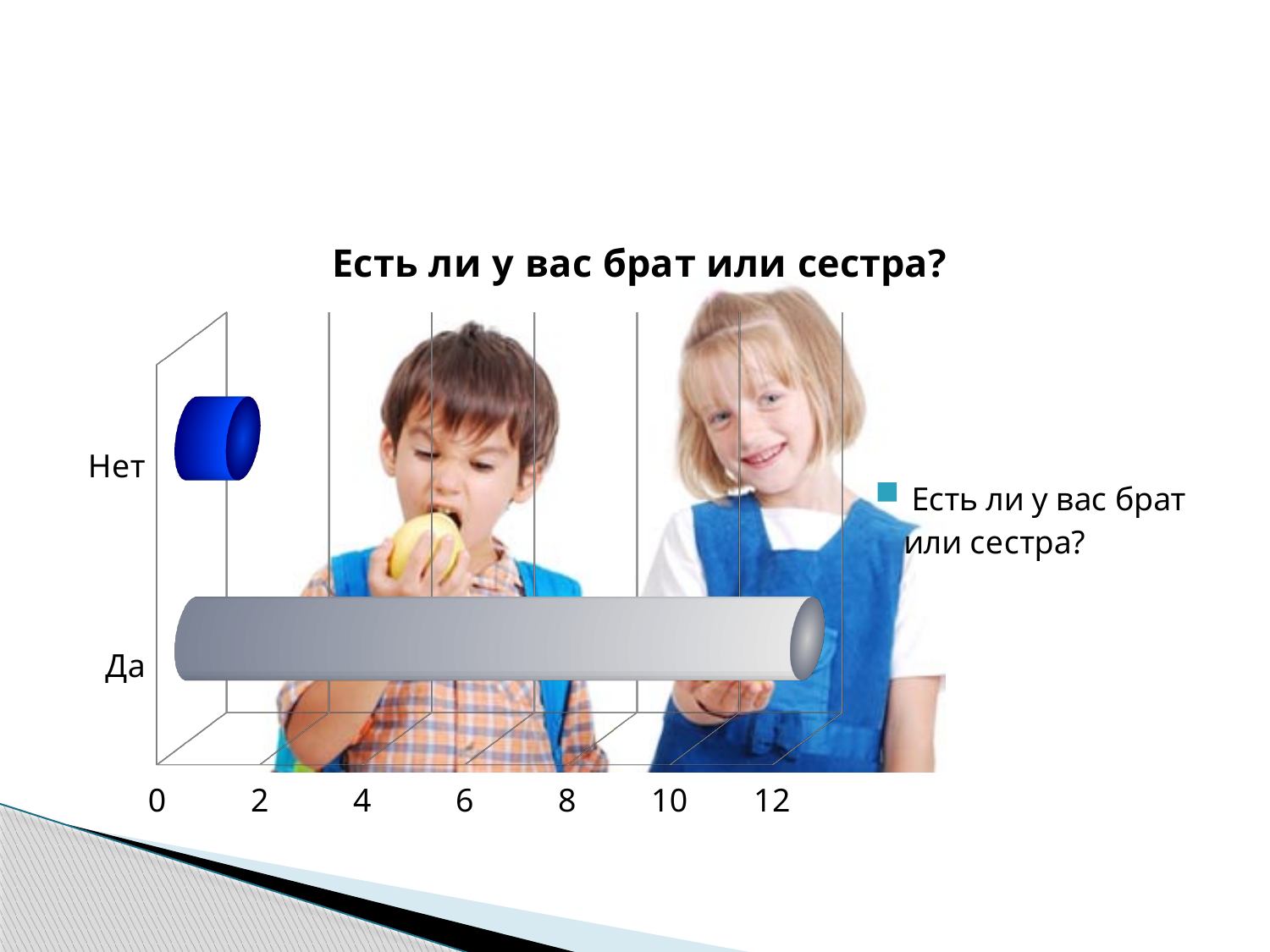
What is the title of the chart? Есть ли у вас брат или сестра? Which category has the lowest value? Нет Is the value for Да greater or less than 10? greater Is the value for Да greater or less than 6? greater What kind of chart is shown on the slide? bar chart Which category has the highest value? Да How many series does the legend list? 1 Which is larger, the value for Да or the value for Нет? Да How many categories are shown on the chart? 2 Is the value for Нет greater or less than 2? less What is the highest value shown on the horizontal axis? 12